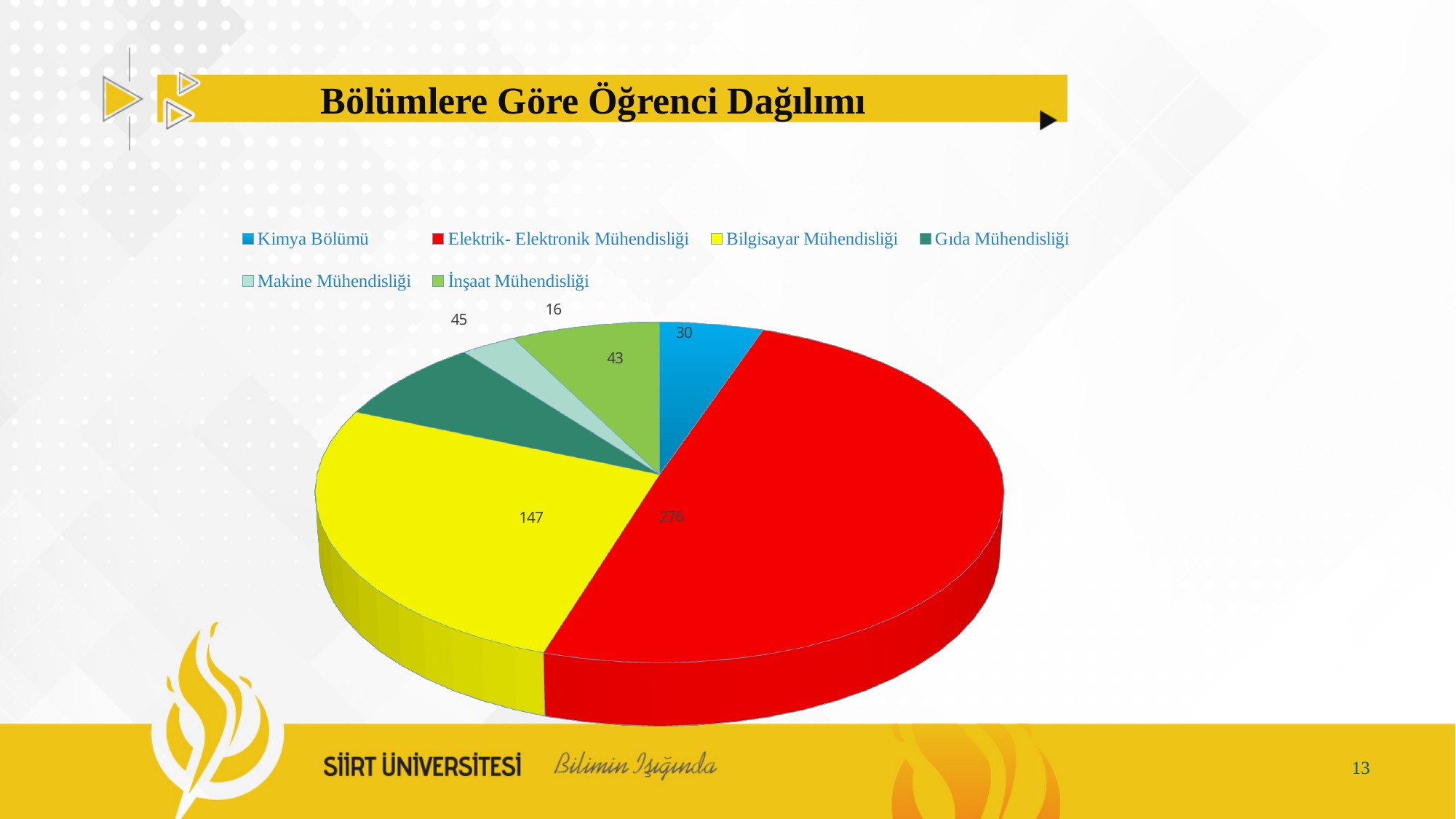
What is the total number of students across all departments in the pie chart? 557 Which has more students, Gıda Mühendisliği or İnşaat Mühendisliği? Gıda Mühendisliği How many departments does the legend list? 6 Which department has the largest number of students? Elektrik- Elektronik Mühendisliği How many students are in Elektrik- Elektronik Mühendisliği? 276 What kind of chart is shown on the slide? Pie chart What is the difference between the number of students in Elektrik- Elektronik Mühendisliği and Bilgisayar Mühendisliği? 129 What is the title of the chart? Bölümlere Göre Öğrenci Dağılımı How many students are in Kimya Bölümü? 30 Which department has the smallest number of students? Makine Mühendisliği How many students are in Makine Mühendisliği? 16 How many students are in Bilgisayar Mühendisliği? 147